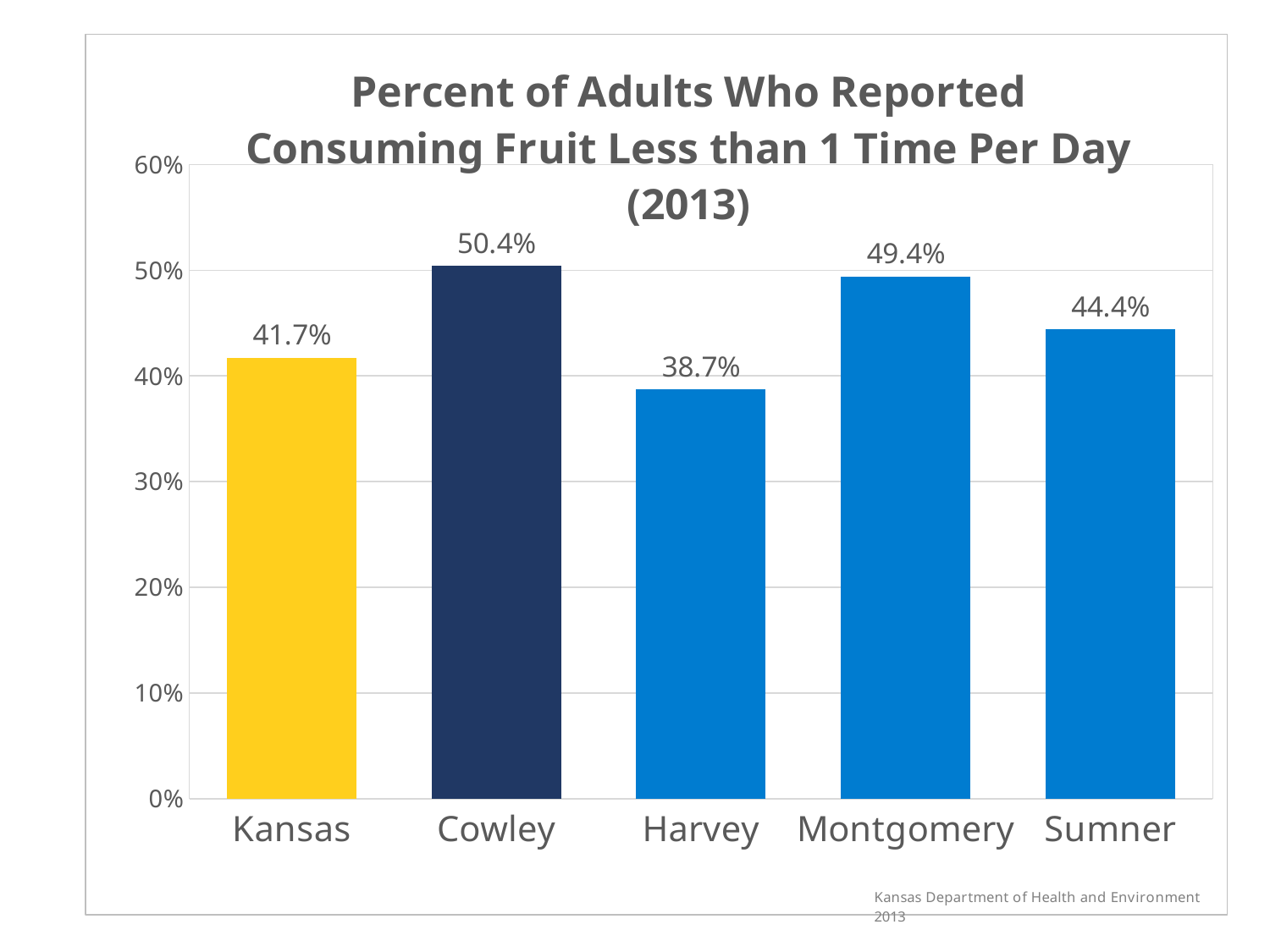
What is the value for Sumner? 44.4% What is the value for Kansas? 41.7% How many categories are shown on the chart? 5 What is the value for Montgomery? 49.4% What is the value for Harvey? 38.7% What is the difference between the values for Cowley and Harvey? 11.7% What kind of chart is shown on the slide? Bar chart Which is larger, the value for Sumner or the value for Kansas? Sumner Which category has the highest value? Cowley What is the value for Cowley? 50.4% Which category has the lowest value? Harvey What colour is the bar for Kansas? Yellow